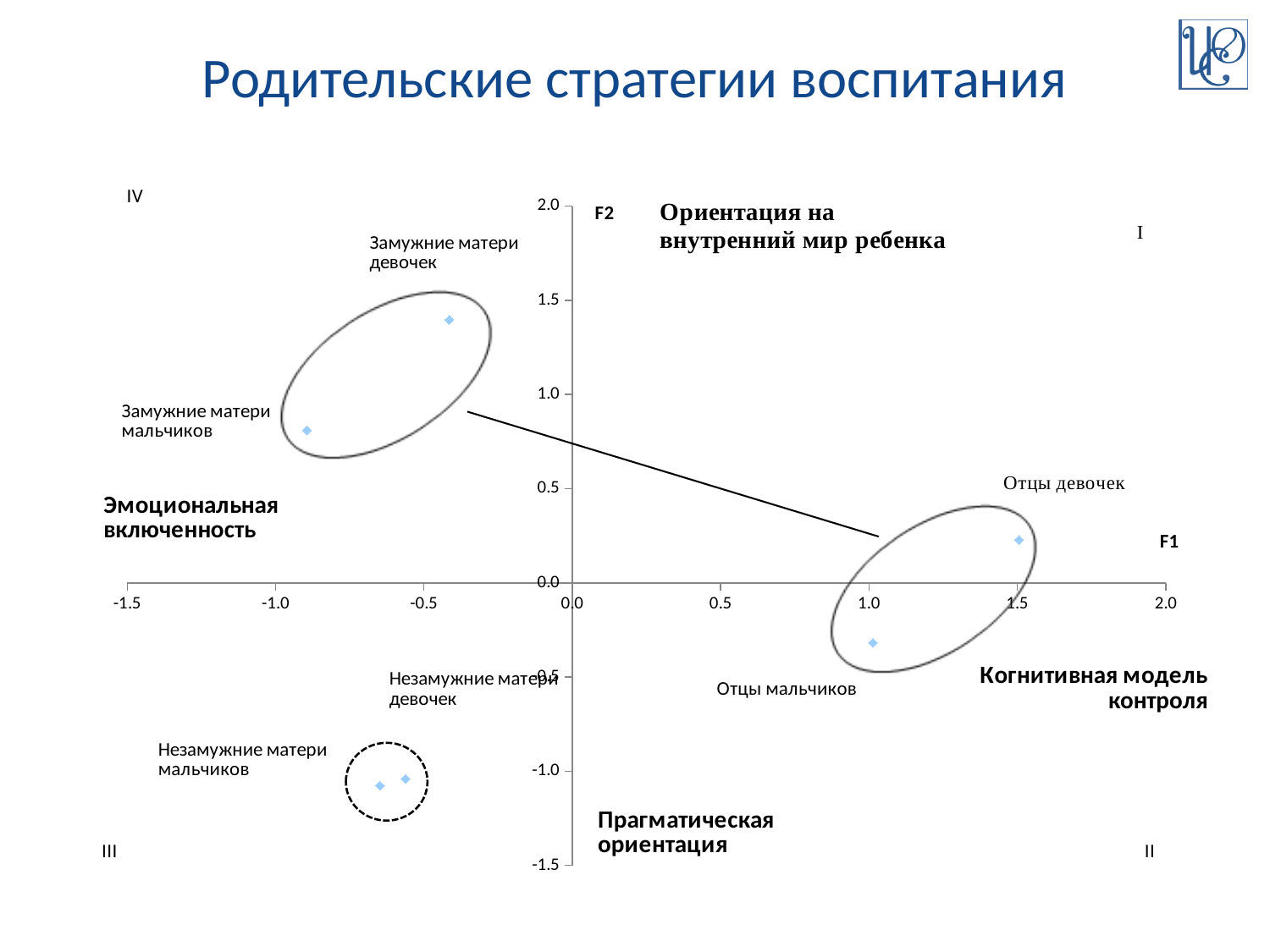
Which has the higher F2 value, Отцы девочек or Отцы мальчиков? Отцы девочек Is the F2 value for Замужние матери девочек greater or less than 1.0? greater Which group has the highest value on the F2 axis? Замужние матери девочек Is the F2 value for Отцы мальчиков greater or less than 0.0? less Is the F2 value for Незамужние матери мальчиков greater or less than -0.5? less What kind of chart is shown on the slide? scatter chart What are the labels of the horizontal and vertical axes? F1 and F2 Which group has the lowest value on the F1 axis? Замужние матери мальчиков What is the title of the slide? Родительские стратегии воспитания How many data points are plotted on the chart? 6 Which group has the highest value on the F1 axis? Отцы девочек